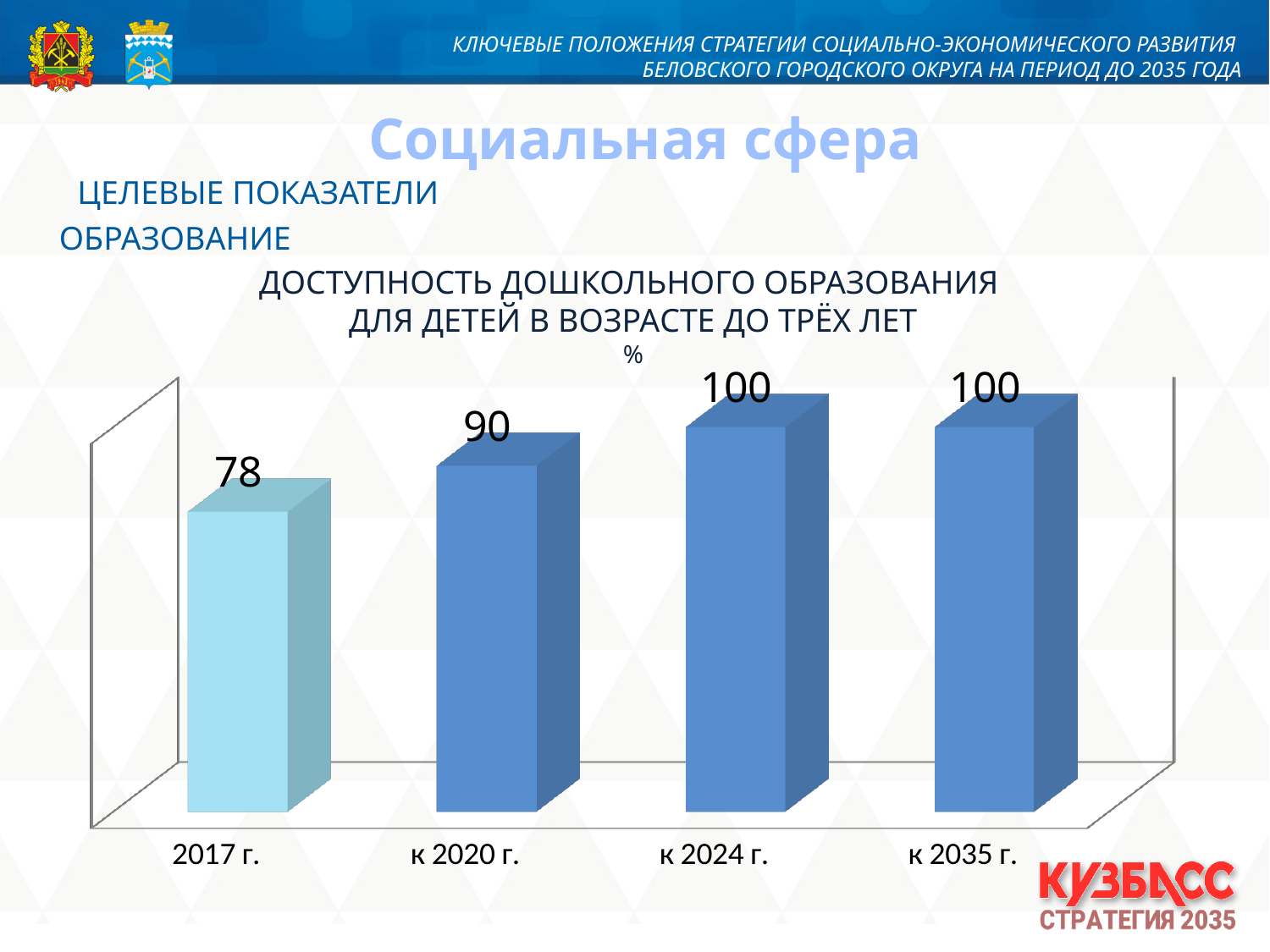
Which is larger, the value for 2017 г. or the value for к 2020 г.? к 2020 г. Which category has the lowest value? 2017 г. What is the difference between the values for к 2024 г. and к 2020 г.? 10 What is the value for к 2035 г.? 100 How many categories are shown on the x axis? 4 Do the values rise or fall from 2017 г. to к 2024 г.? rise What kind of chart is this? bar chart What is the value for к 2020 г.? 90 What is the difference between the values for к 2020 г. and 2017 г.? 12 What unit is shown above the chart? % What is the value for 2017 г.? 78 What is the value for к 2024 г.? 100